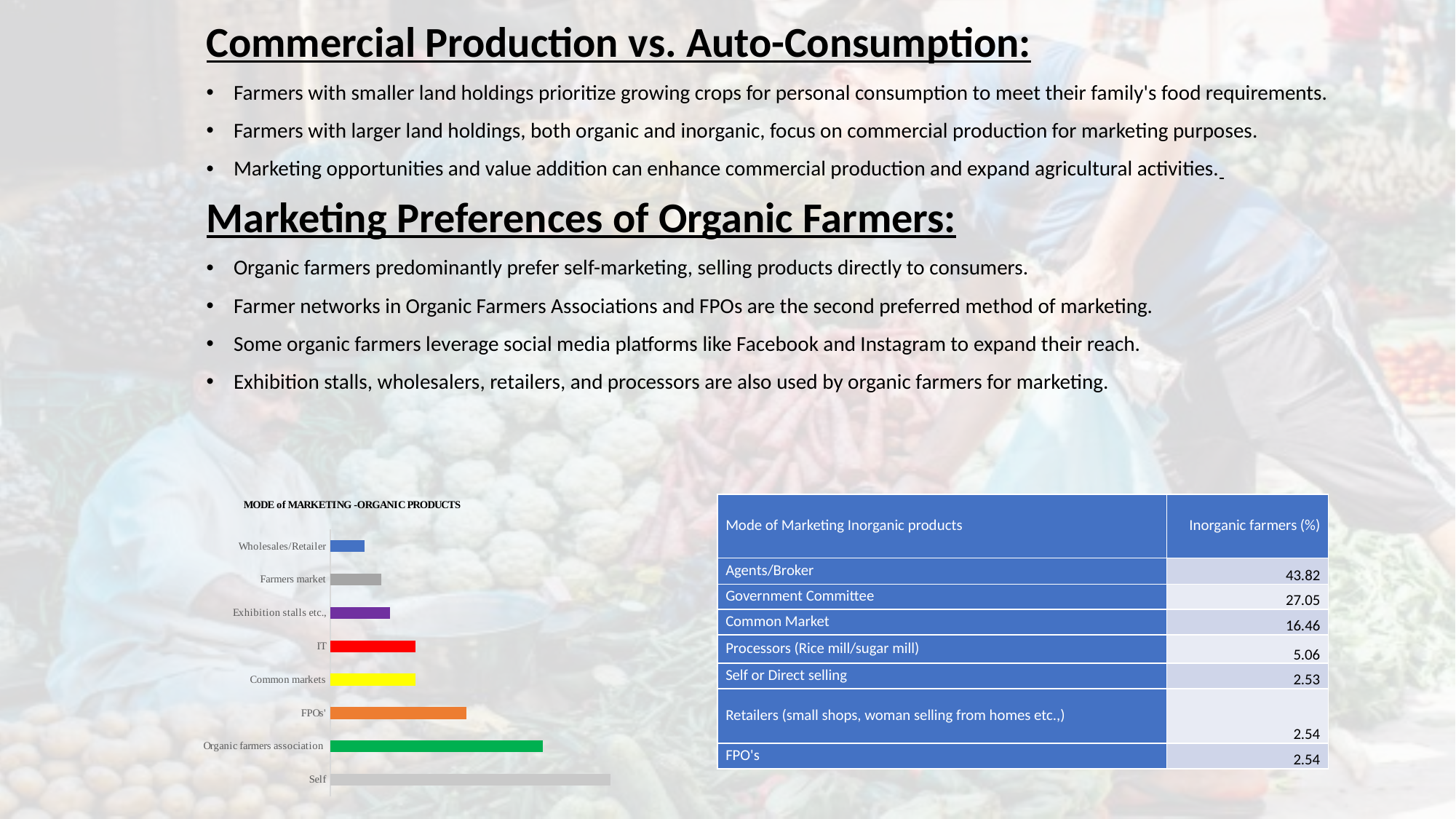
Which category has the shortest bar in the chart? Wholesales/Retailer What kind of chart is shown on the slide? bar chart Which has the larger value in the chart, Self or Organic farmers association? Self What is the title of the chart on the slide? MODE of MARKETING -ORGANIC PRODUCTS What colour is the bar for Organic farmers association in the chart? green How many categories are plotted in the chart? 8 Which has the larger value in the chart, Organic farmers association or FPOs'? Organic farmers association Which has the larger value in the chart, Exhibition stalls etc., or Wholesales/Retailer? Exhibition stalls etc., Which category has the longest bar in the chart? Self